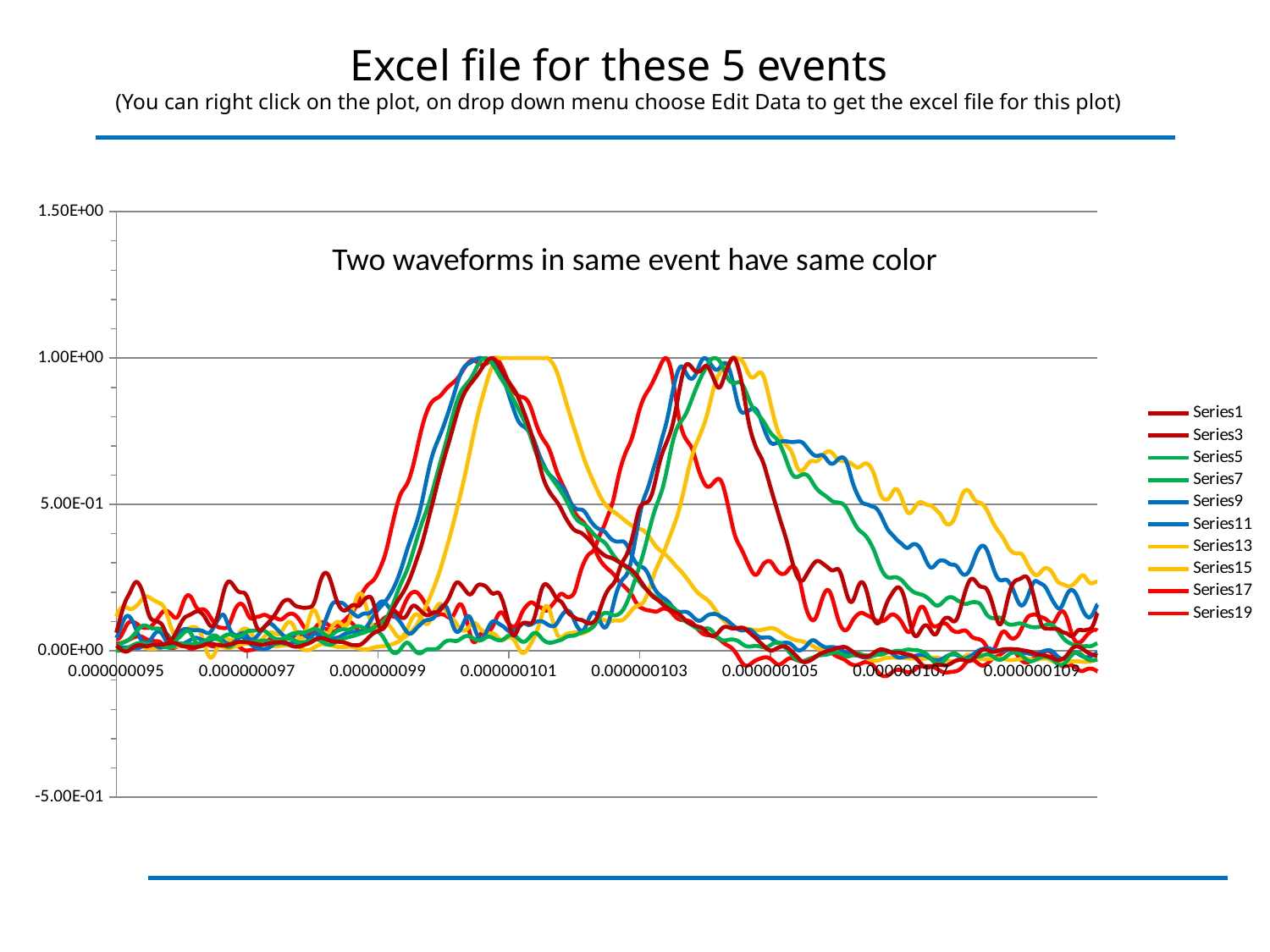
How many tick labels are shown on the horizontal axis? 8 What is the leftmost label on the horizontal axis? 0.000000095 What is the rightmost label on the horizontal axis? 0.000000109 What is the lowest value shown on the vertical axis? -5.00E-01 Is the peak value of the waveforms greater or less than 1.50E+00? less What kind of chart is shown on the slide? line chart What is the highest value shown on the vertical axis? 1.50E+00 What is the first series name listed in the legend? Series1 How many series does the legend list? 10 At the horizontal axis value 0.000000095, are the waveform values greater or less than 5.00E-01? less What is the last series name listed in the legend? Series19